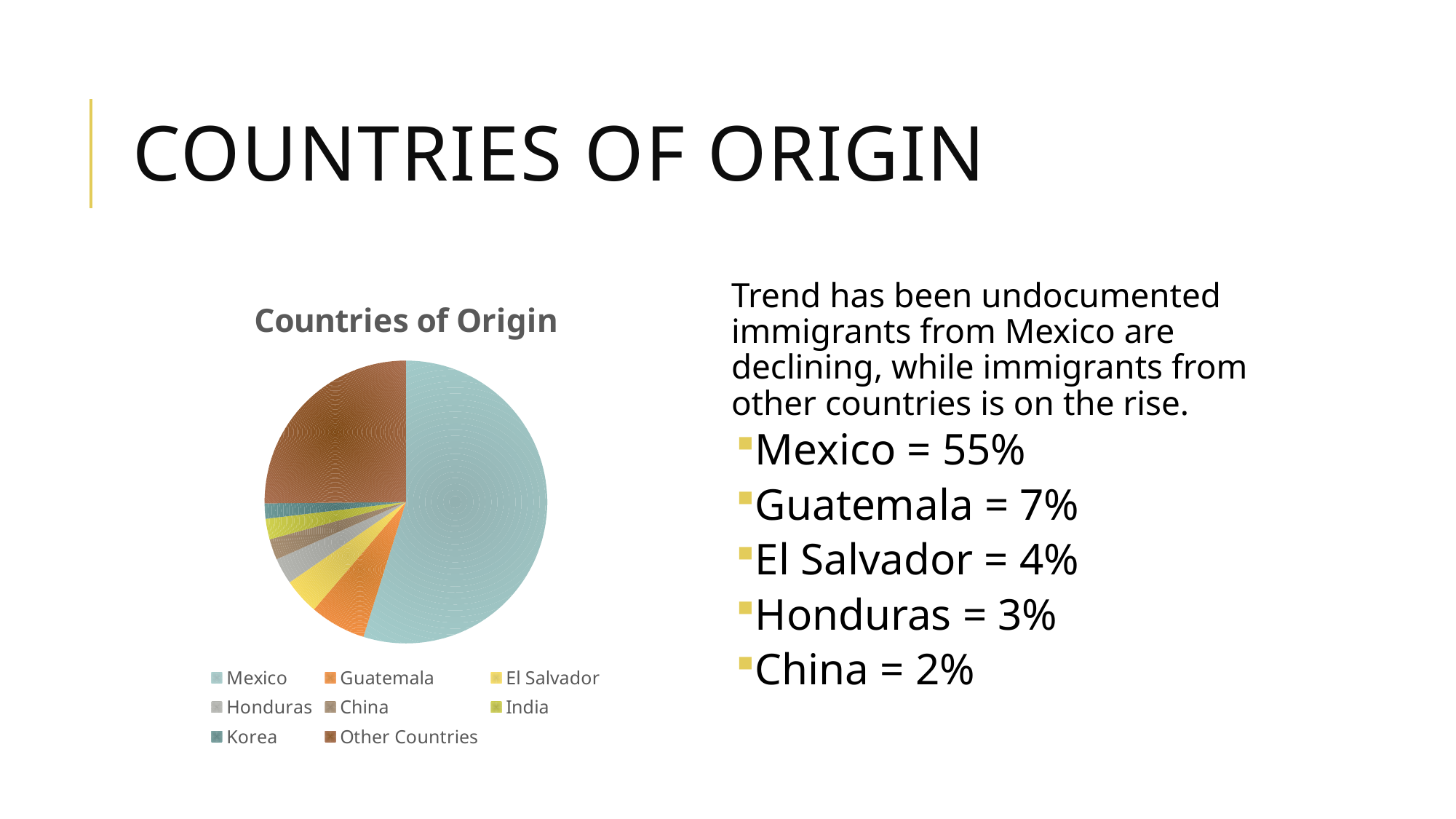
What is the difference between the values for Mexico and Guatemala? 48% Which country has the largest slice of the pie? Mexico Which is larger, the slice for Mexico or the slice for Other Countries? Mexico What is the title of the chart? Countries of Origin What share of the pie does Mexico account for? 55% What is the value for China? 2% What kind of chart is shown on the slide? pie chart What is the value for El Salvador? 4% Which legend entry is shown in brown, listed last in the legend? Other Countries How many categories does the pie chart's legend list? 8 What is the value for Guatemala? 7% What is the value for Honduras? 3%